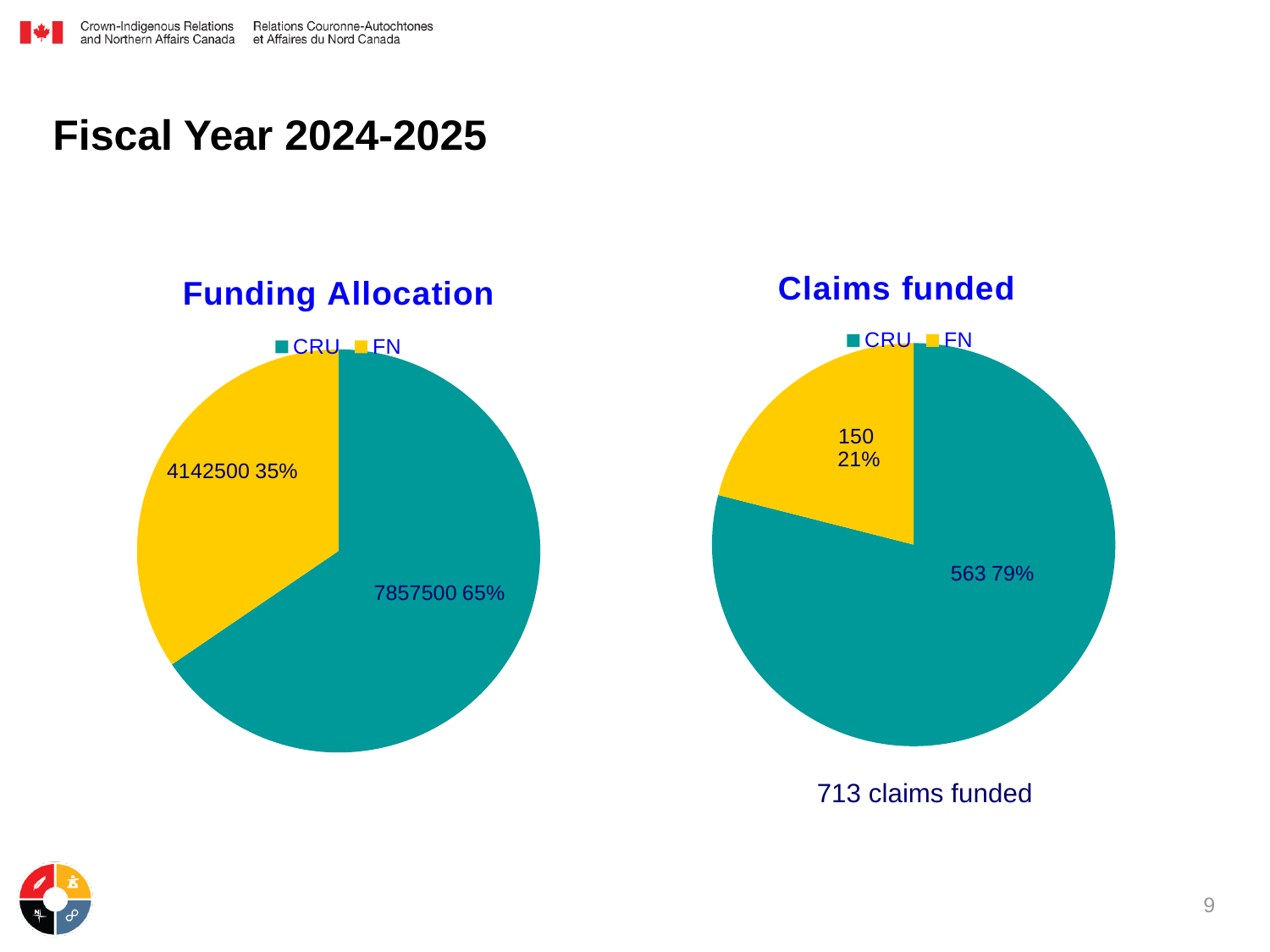
In the Claims funded chart, which category has the smallest slice? FN In the Claims funded chart, what is the value for CRU? 563 In the Claims funded chart, what is the total of the CRU and FN values? 713 In the Funding Allocation chart, what is the value for CRU? 7857500 What kind of chart is the Funding Allocation chart? Pie chart In the Funding Allocation chart, what is the difference between the CRU and FN values? 3715000 In the Funding Allocation chart, what is the value for FN? 4142500 In the Funding Allocation chart, which category has the largest slice? CRU In the Claims funded chart, what is the value for FN? 150 How many categories does the legend of the Claims funded chart list? 2 In the Funding Allocation chart, what share of the pie does FN represent? 35% In the Claims funded chart, what share of the pie does CRU represent? 79%